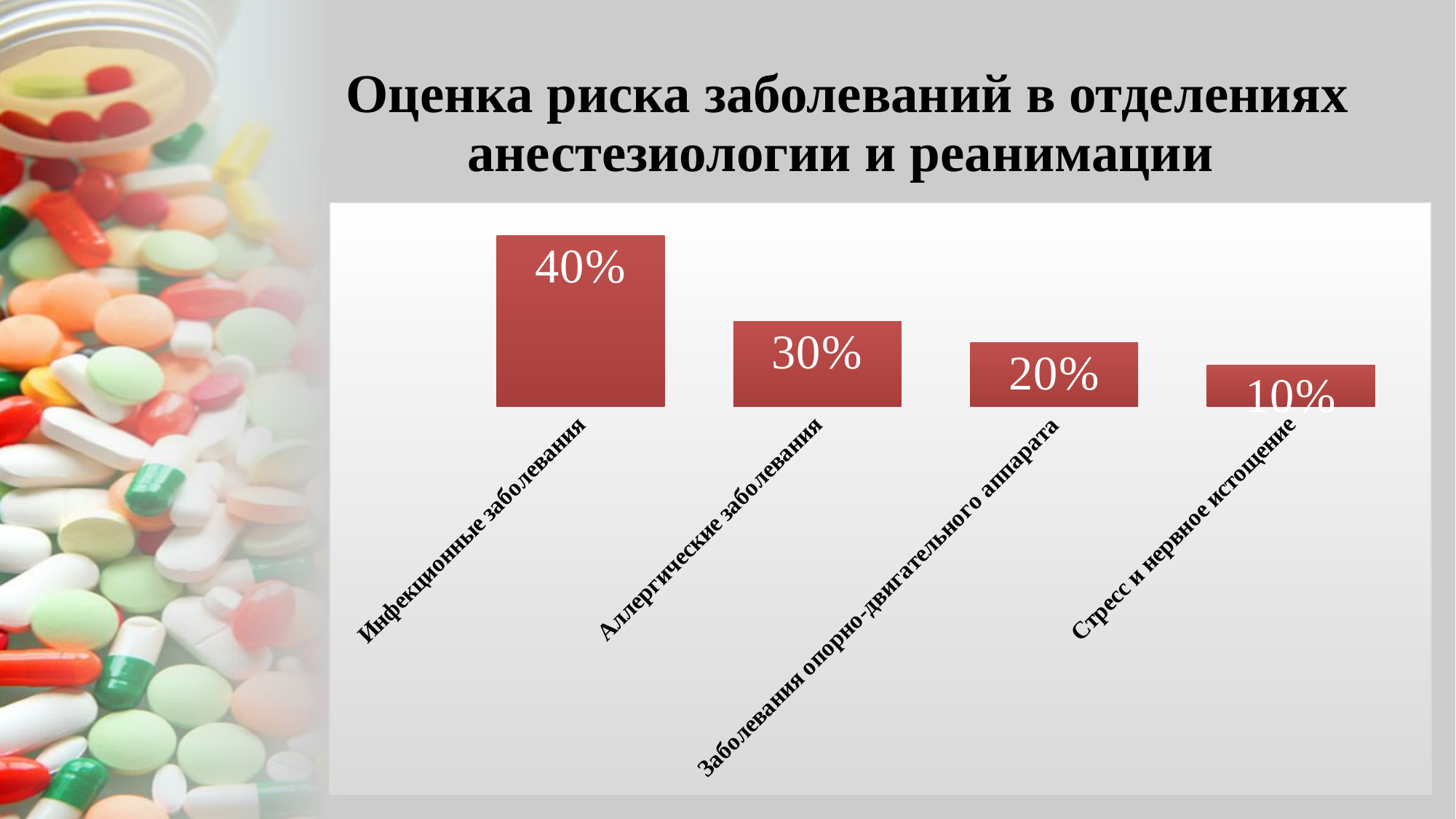
What is the value for Инфекционные заболевания? 40% What kind of chart is shown on the slide? Bar chart Which is larger: the value for Аллергические заболевания or the value for Стресс и нервное истощение? Аллергические заболевания What is the value for Аллергические заболевания? 30% What is the value for Заболевания опорно-двигательного аппарата? 20% Which category has the lowest value? Стресс и нервное истощение What is the value for Стресс и нервное истощение? 10% How many categories are shown in the chart? 4 Do the values rise or fall from left to right along the x axis? Fall Which category has the highest value? Инфекционные заболевания What is the difference between the values for Аллергические заболевания and Заболевания опорно-двигательного аппарата? 10% What is the difference between the values for Инфекционные заболевания and Стресс и нервное истощение? 30%